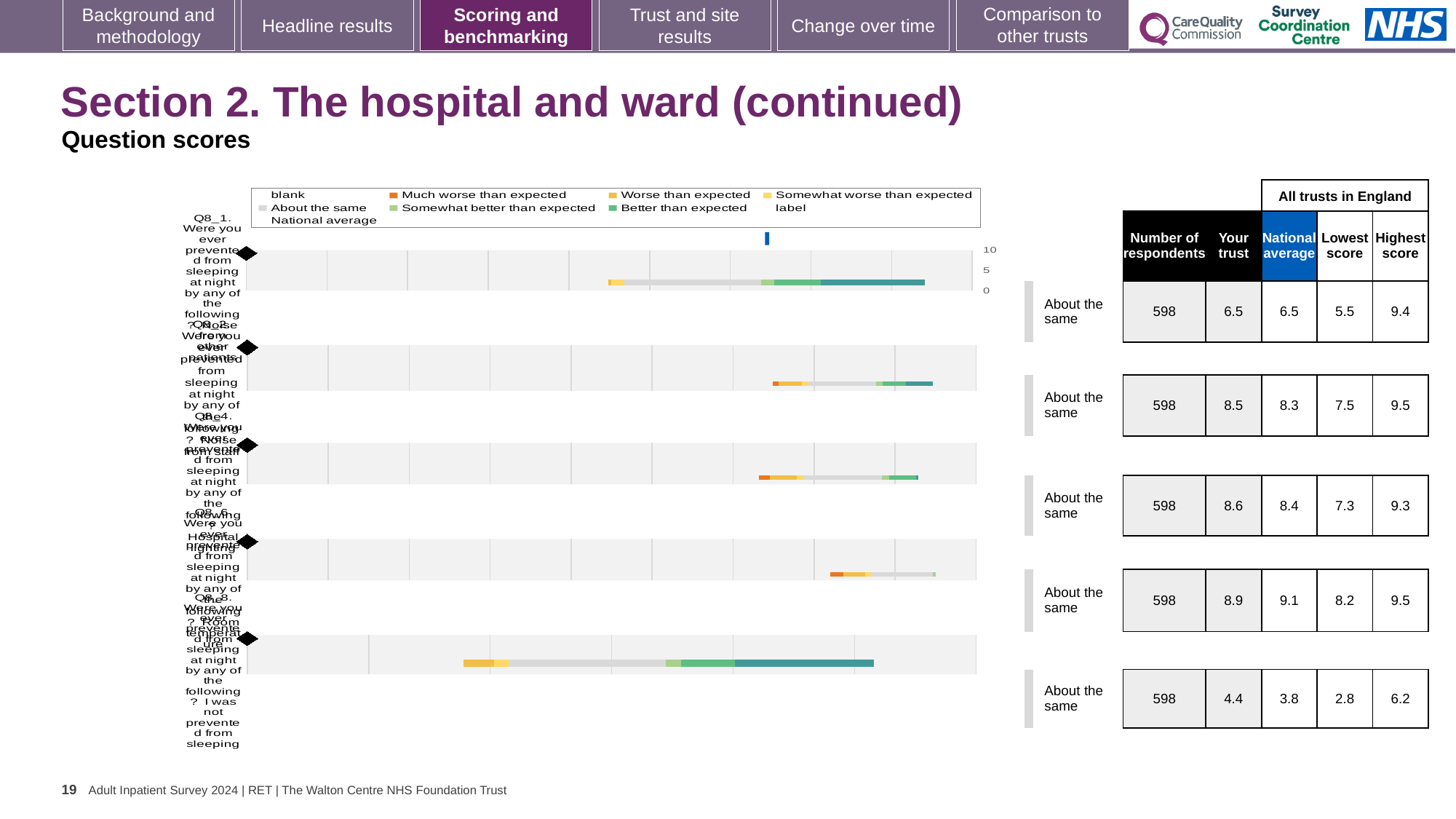
How many respondents are listed for each question row? 598 Which question row has the highest 'Your trust' score? the fourth row (8.9) What is the difference between the 'Your trust' score and the national average for the fifth (bottom) question row? 0.6 What benchmark category is shown for every question row on the slide? About the same What is the highest score among all trusts in England for the third question row? 9.3 Which question row has the lowest 'Your trust' score? the fifth (bottom) row (4.4) What kind of chart is shown on the slide? bar chart How many question rows (bars) are plotted in the chart? 5 For the second question row, is the 'Your trust' score or the national average larger? Your trust (8.5) What is the 'Your trust' score for the fifth (bottom) question row? 4.4 What is the 'Your trust' score for the first (top) question row? 6.5 What is the national average for the fourth question row? 9.1